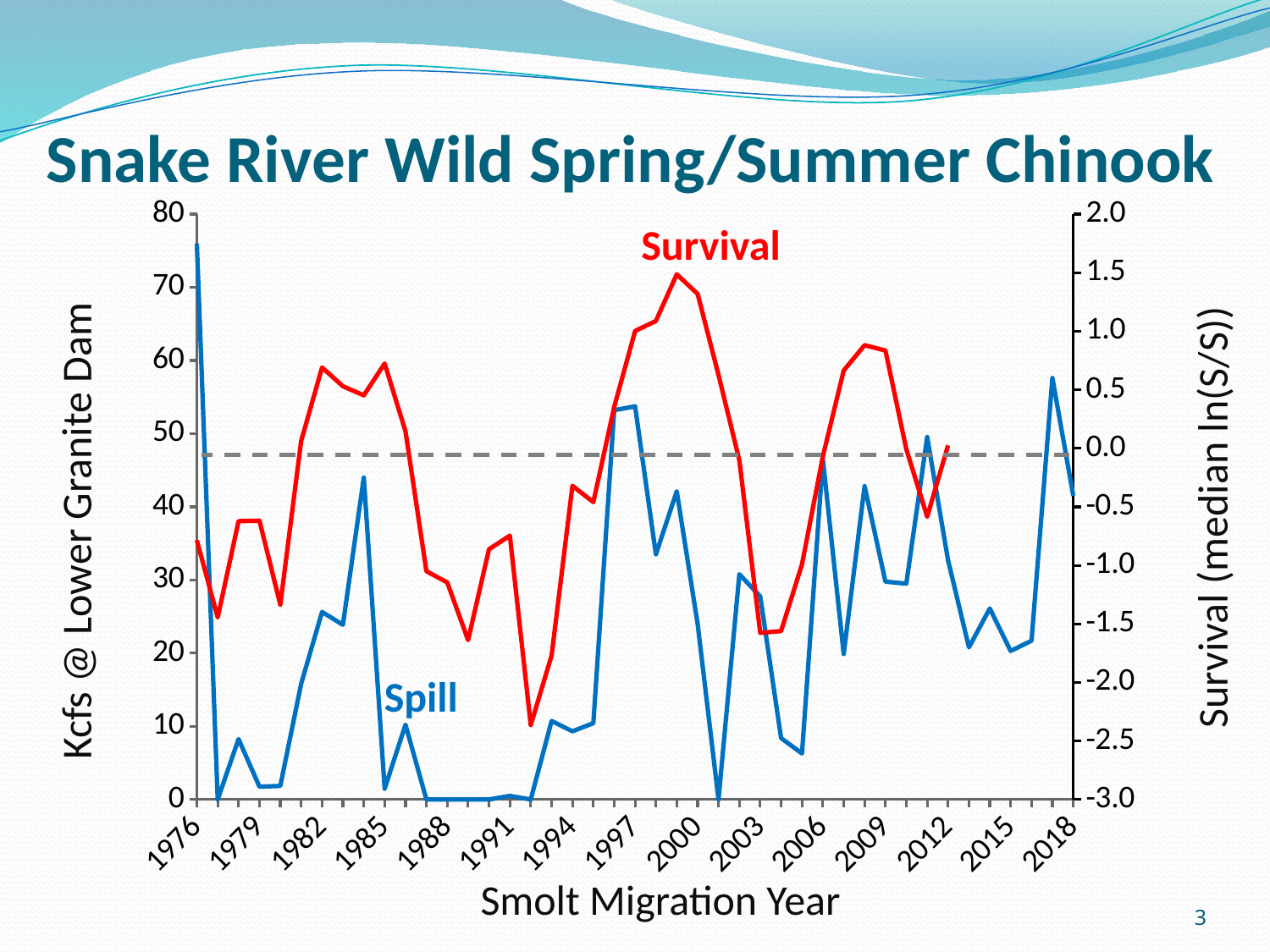
Which series reaches its highest value in 1976? Spill How many data series are plotted on the chart? 2 What kind of chart is shown on the slide? line chart Does the Survival series rise or fall from 1997 to 1999? rise What is the label of the x axis? Smolt Migration Year What is the title of the chart on the slide? Snake River Wild Spring/Summer Chinook Which year has the higher Spill value, 1976 or 1985? 1976 Is the Survival value for 1999 greater or less than 1.0? greater Is the Spill value for 2018 greater or less than 50? less Is the Survival value for 1992 greater or less than -2.0? less Which year has the higher Survival value, 1999 or 2008? 1999